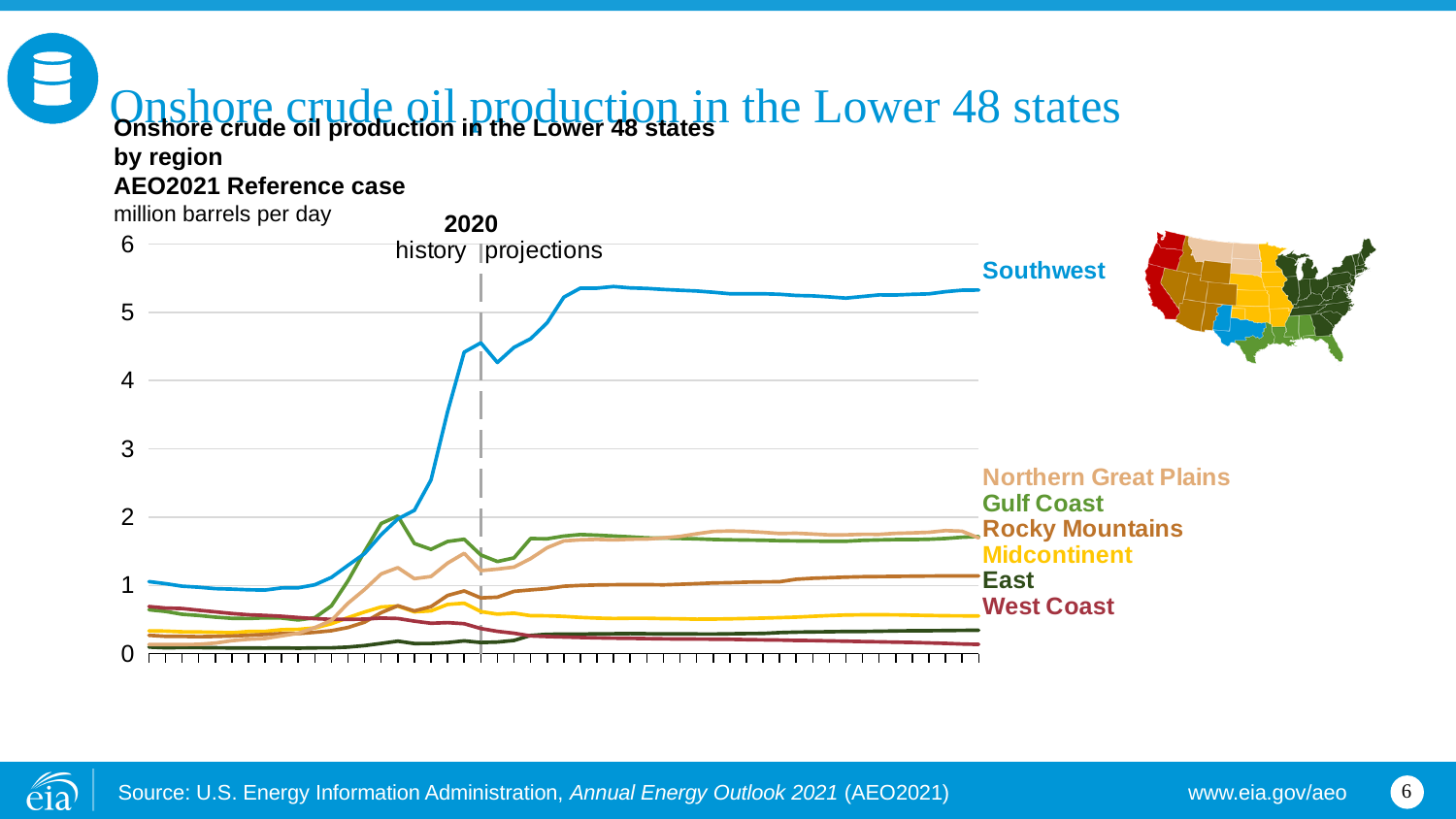
What year does the dashed vertical line separating history from projections mark? 2020 At the end of the projection period, which is larger: Rocky Mountains or Midcontinent? Rocky Mountains Which region has the highest onshore crude oil production at the end of the projection period? Southwest At the end of the projection period, which is larger: Southwest or Gulf Coast? Southwest Is the Midcontinent value at the end of the projection period greater or less than 1 million barrels per day? less Does the West Coast line rise or fall over the period shown? fall How many regions (series) are plotted on the chart? 7 What kind of chart is shown on the slide? line chart What unit is used on the chart's y axis? million barrels per day Which region has the lowest onshore crude oil production at the end of the projection period? West Coast Is the Southwest value in 2020 greater or less than 4 million barrels per day? greater Is the Southwest value at the end of the projection period greater or less than 5 million barrels per day? greater